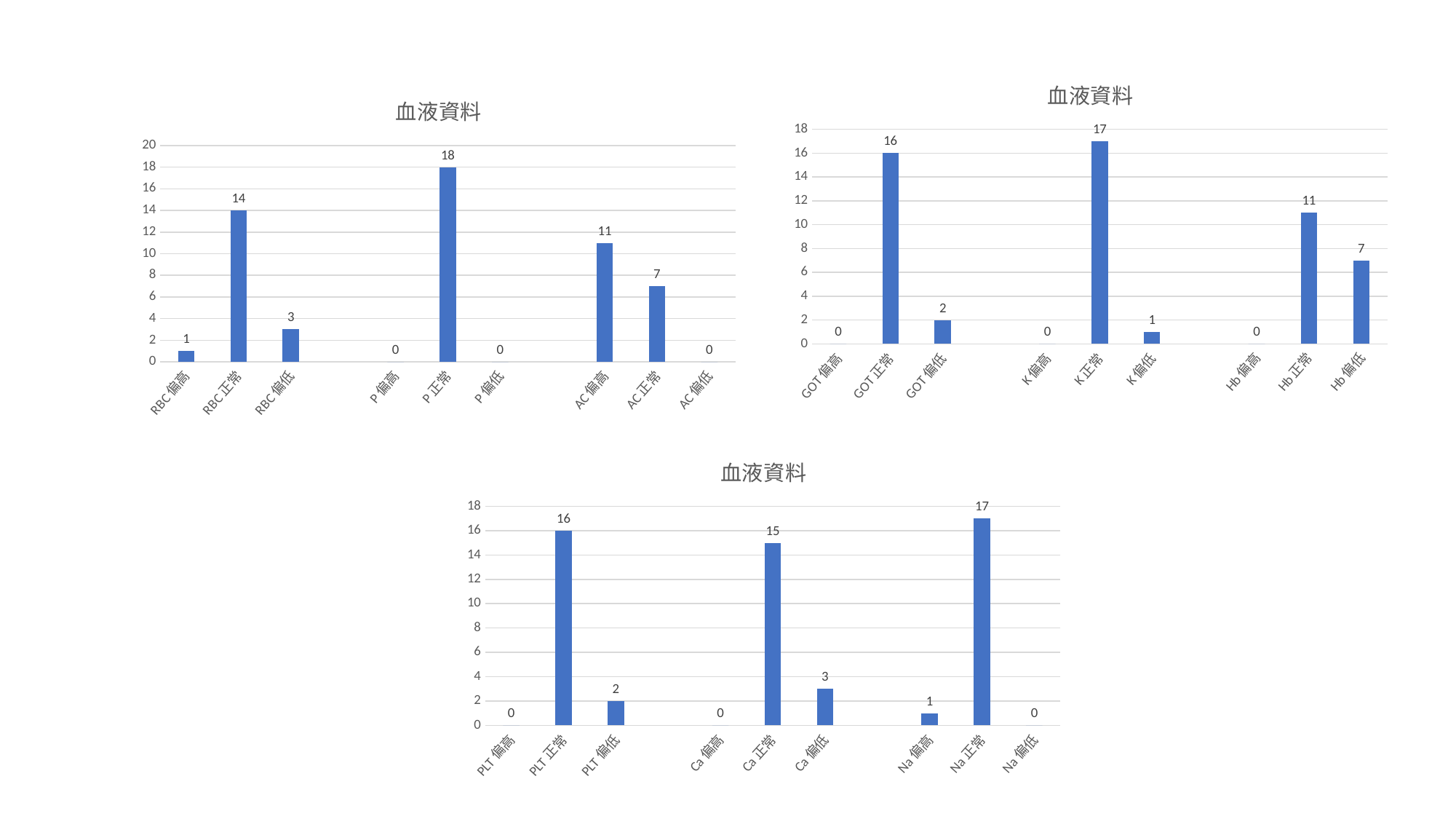
In the bottom chart, what is the difference between PLT 正常 and Ca 偏低? 13 In the top-left chart, how many categories are shown on the x axis? 9 In the bottom chart, which category has the highest value? Na 正常 In the top-right chart, what is the value for Hb 偏低? 7 In the top-right chart, which category has the highest value? K 正常 In the top-left chart, what is the value for RBC 正常? 14 In the top-left chart, what is the difference between P 正常 and AC 偏高? 7 What type of chart is the bottom chart? Bar chart In the bottom chart, what is the value for Ca 正常? 15 In the top-right chart, what is the difference between GOT 偏低 and K 偏低? 1 In the top-right chart, which is larger, GOT 正常 or Hb 正常? GOT 正常 In the top-left chart, which category has the highest value? P 正常